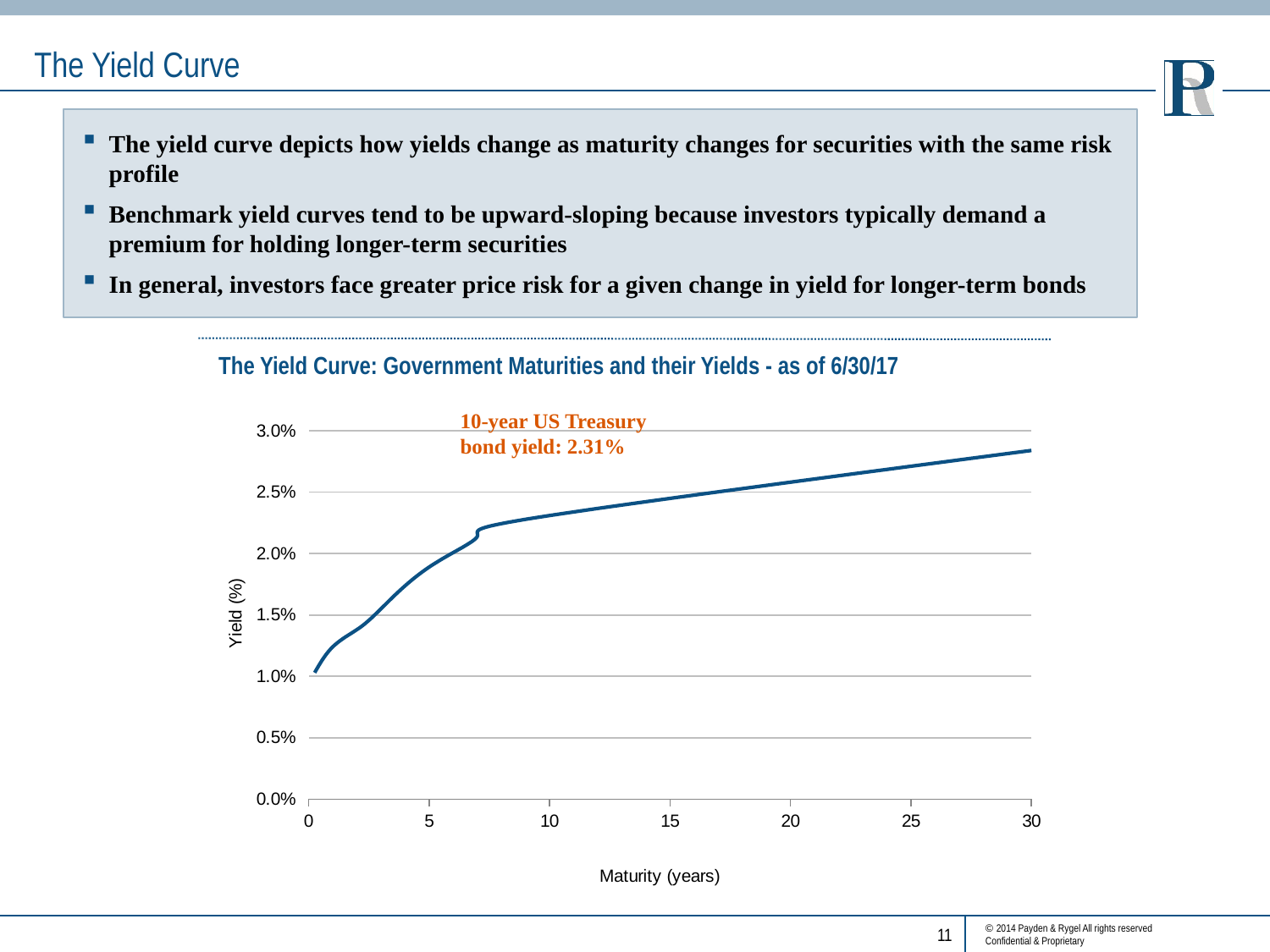
What is the title of the chart? The Yield Curve: Government Maturities and their Yields - as of 6/30/17 Is the yield at a 30-year maturity greater or less than 2.5%? greater Is the yield at a 5-year maturity greater or less than 2.0%? less What is the 10-year US Treasury bond yield shown on the chart? 2.31% What kind of chart is shown on the slide? line chart Which has the higher yield, the 5-year maturity or the 30-year maturity? 30-year maturity Is the yield at a 15-year maturity greater or less than 2.0%? greater What is the label of the x axis? Maturity (years) Do yields rise or fall as maturity increases along the x axis? rise At which maturity on the chart is the yield highest? 30 years